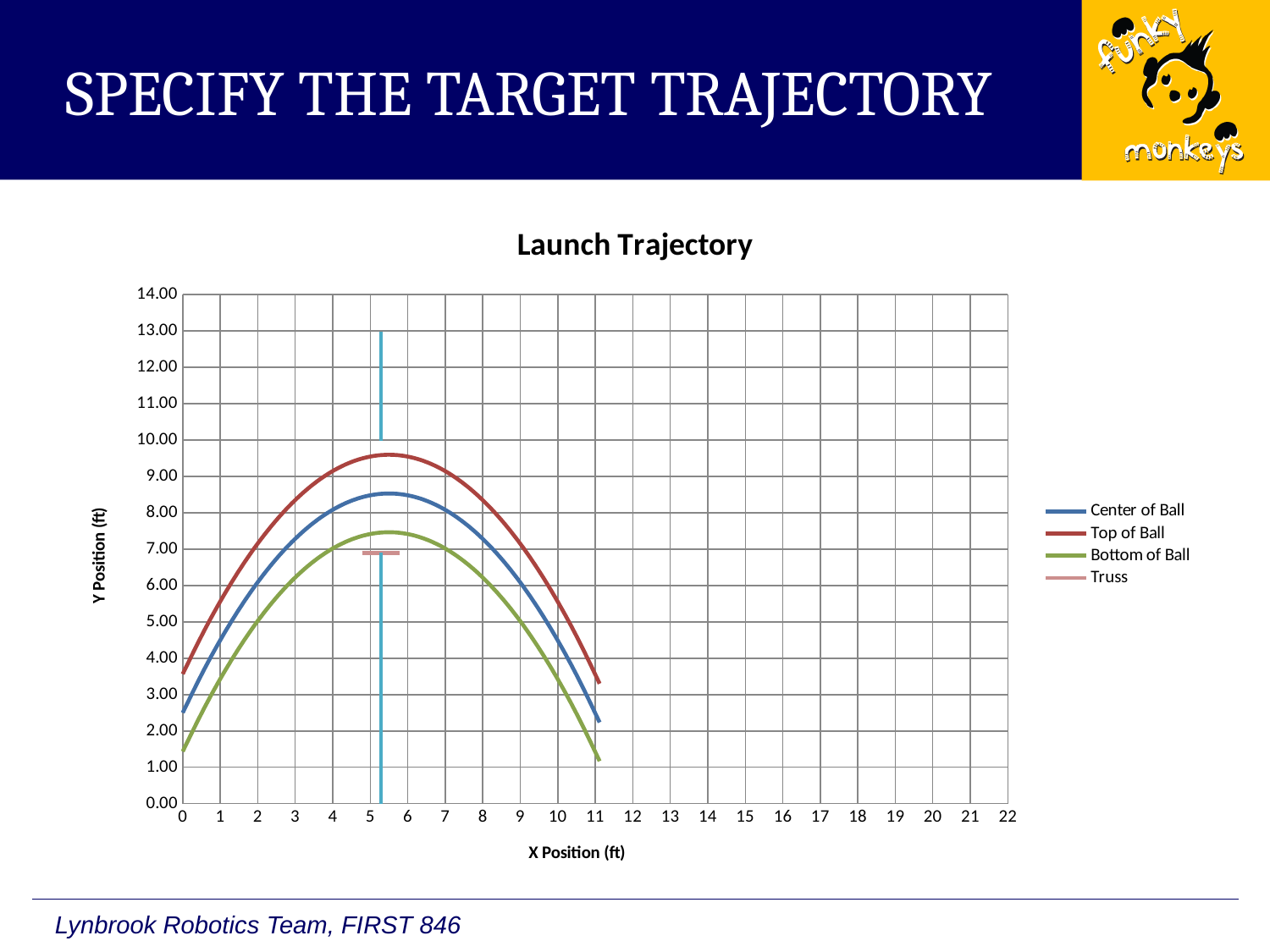
How many series does the legend of the Launch Trajectory chart list? 4 Is the peak Y Position of the Center of Ball series greater or less than 8.00? greater Does the Center of Ball series rise or fall as X Position goes from 7 to 11? fall Which series in the Launch Trajectory chart stays lowest in Y Position along its whole path? Bottom of Ball What is the title of the chart on the slide? Launch Trajectory What kind of chart is the Launch Trajectory chart? line chart Which series in the Launch Trajectory chart reaches the highest Y Position? Top of Ball At X Position 5, which is higher: the Top of Ball series or the Bottom of Ball series? Top of Ball Is the peak Y Position of the Bottom of Ball series greater or less than 8.00? less Is the Y Position of the Truss marker greater or less than 8.00? less What is the label of the x axis of the Launch Trajectory chart? X Position (ft)